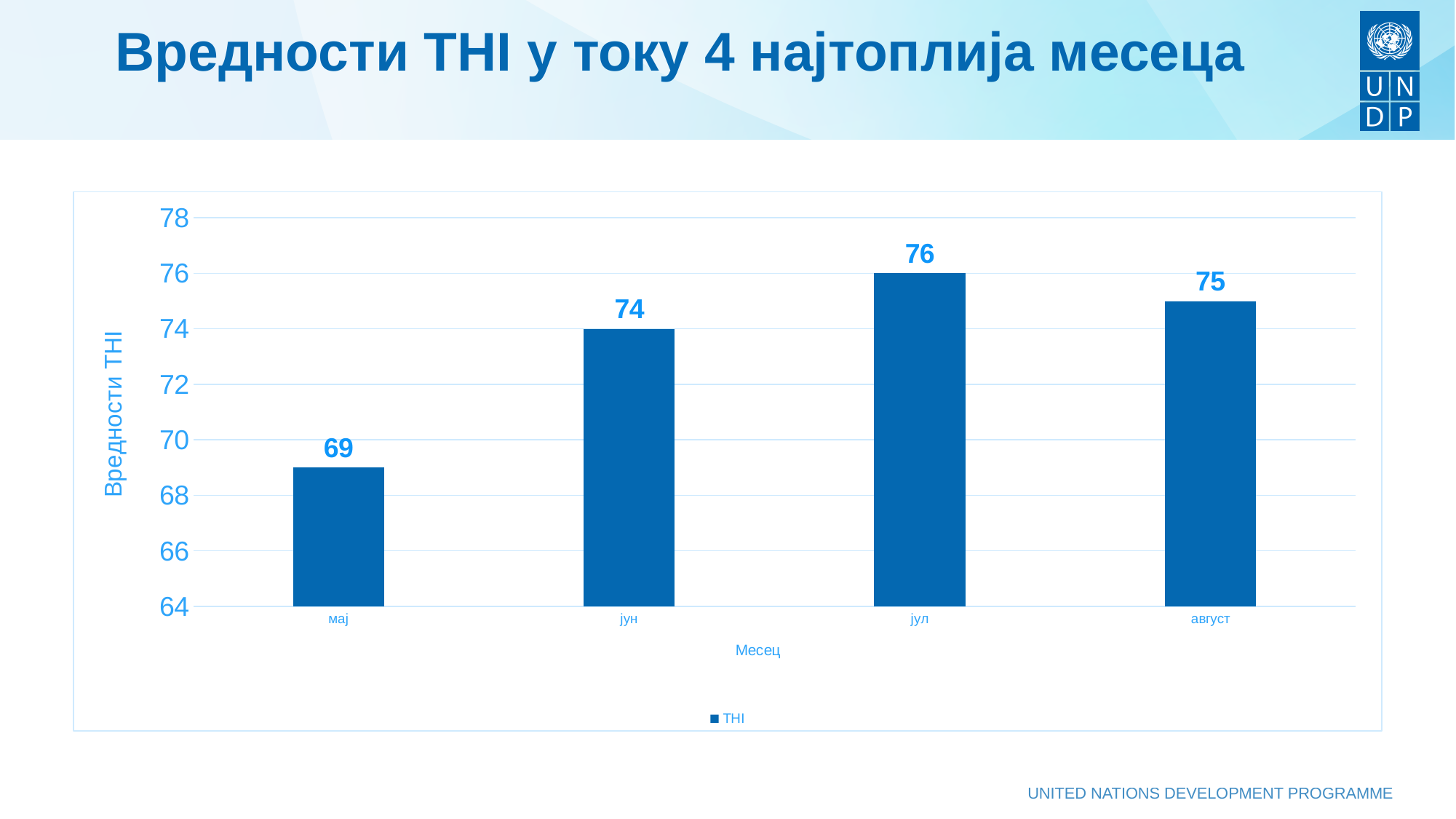
Which month has the highest THI value? јул What kind of chart is shown on the slide? bar chart What is the difference between the THI values for јул and мај? 7 How many series does the legend list? 1 Which month has the lowest THI value? мај What is the THI value for мај? 69 What is the THI value for јул? 76 How many months are shown on the chart? 4 Is the THI value for јун greater or less than 72? greater What is the label of the x axis? Месец Which has a higher THI value, јун or август? август What is the THI value for август? 75